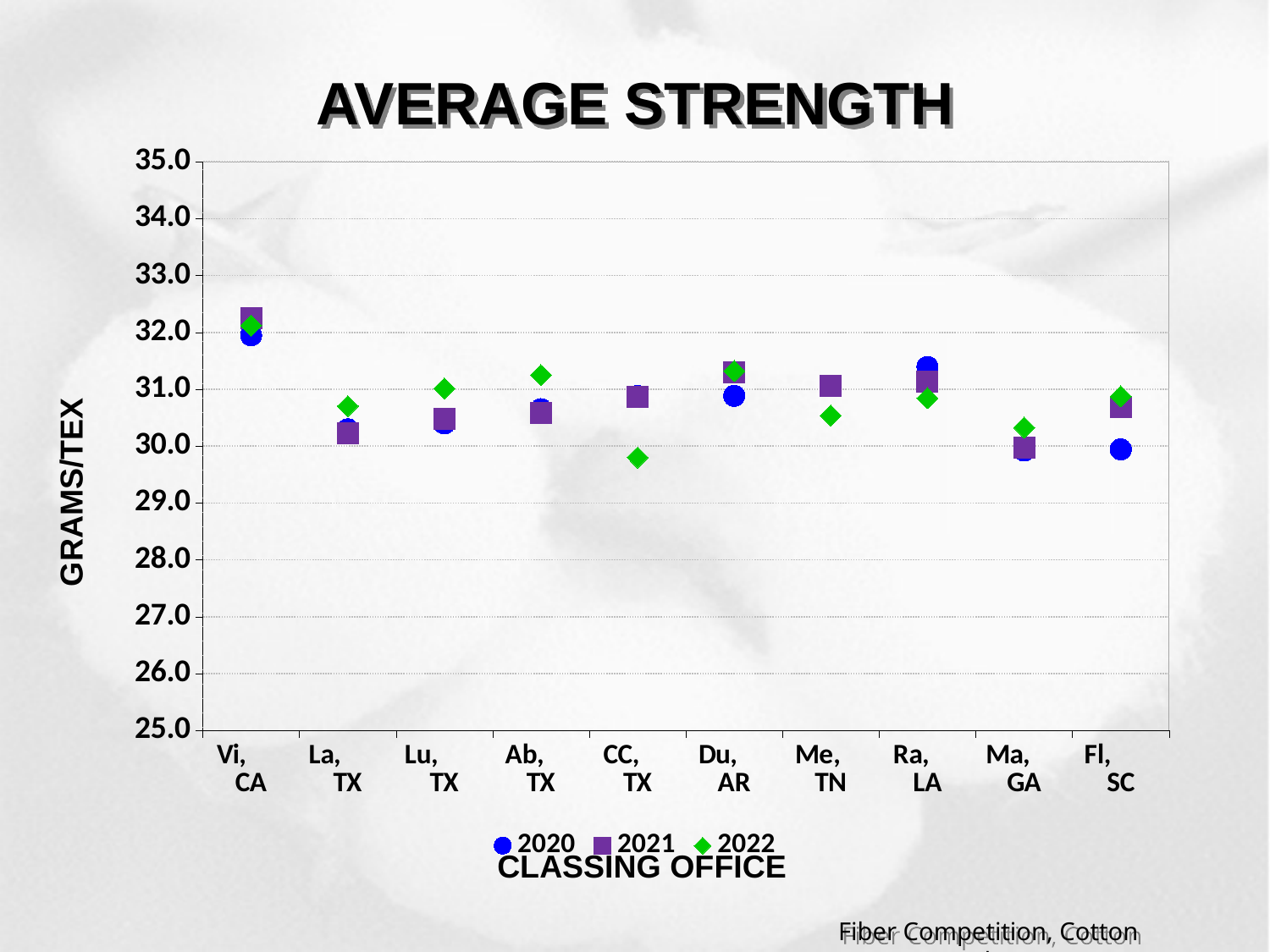
For CC, TX, which year has the higher average strength, 2021 or 2022? 2021 Which classing office has the lowest average strength for 2021? Ma, GA What is the title of the chart? AVERAGE STRENGTH Which classing office has the lowest average strength for 2022? CC, TX What kind of chart is shown on the slide? scatter chart How many series does the legend list? 3 How many classing offices are shown along the x axis? 10 Is the 2022 value for CC, TX greater or less than 30.0? less What is the label on the vertical axis of the chart? GRAMS/TEX Is the 2020 value for Vi, CA greater or less than 31.0? greater Which classing office has the highest average strength for 2022? Vi, CA Is the 2020 value for Ra, LA greater or less than 31.0? greater